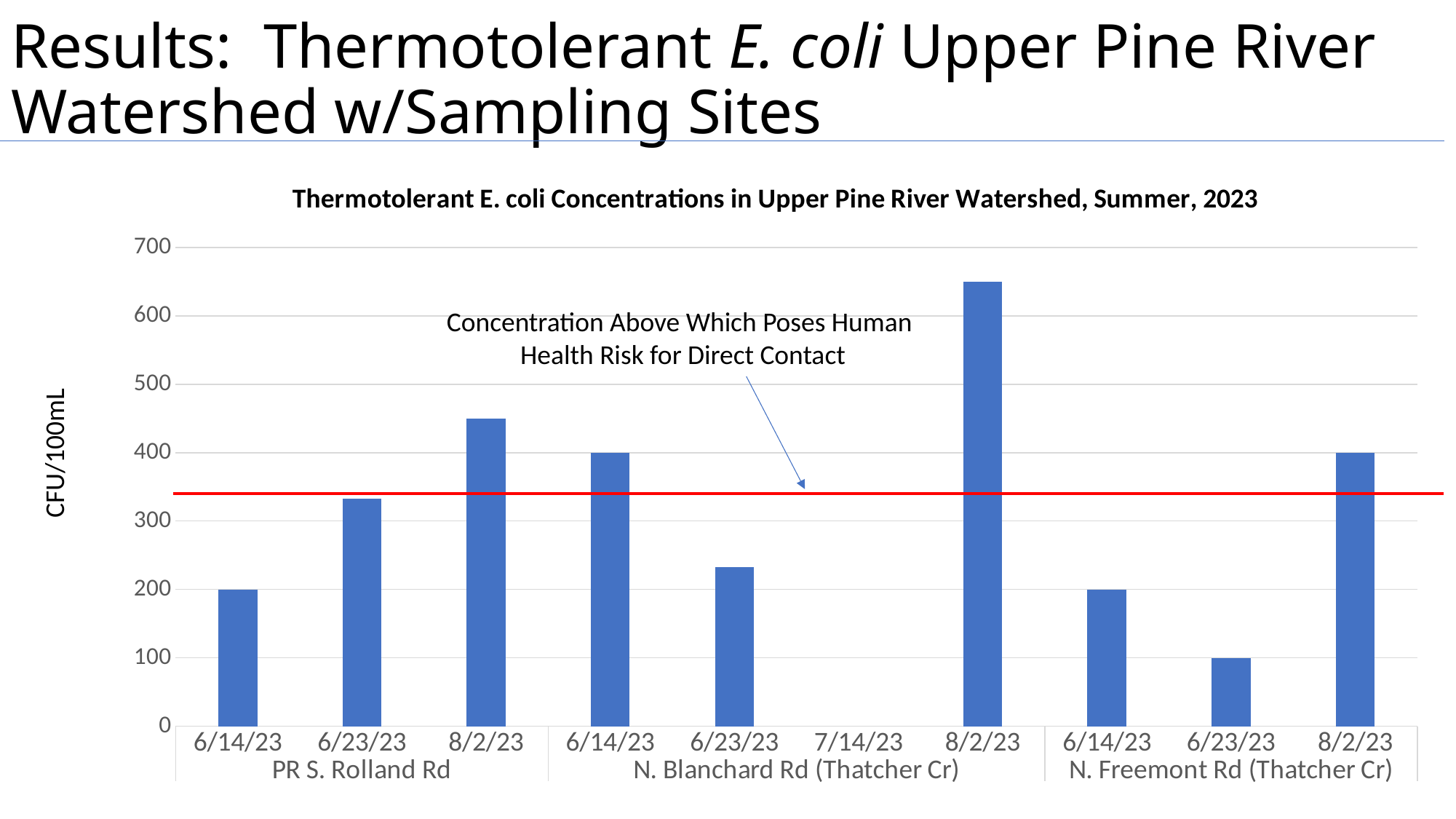
What type of chart is shown on the slide? bar chart Which date and site has the lowest non-zero E. coli concentration in the chart? 6/23/23, N. Freemont Rd (Thatcher Cr) What is the title of the chart? Thermotolerant E. coli Concentrations in Upper Pine River Watershed, Summer, 2023 What is the E. coli concentration for PR S. Rolland Rd on 6/14/23? 200 Which date and site has the highest E. coli concentration in the chart? 8/2/23, N. Blanchard Rd (Thatcher Cr) How many sampling sites are shown along the x axis of the chart? 3 Which is larger: the value for PR S. Rolland Rd on 8/2/23 or the value for N. Blanchard Rd (Thatcher Cr) on 6/23/23? PR S. Rolland Rd on 8/2/23 Is the value for N. Blanchard Rd (Thatcher Cr) on 8/2/23 greater or less than 600? greater What is the E. coli concentration for N. Blanchard Rd (Thatcher Cr) on 6/14/23? 400 What is the label on the vertical axis of the chart? CFU/100mL What is the E. coli concentration for N. Freemont Rd (Thatcher Cr) on 8/2/23? 400 What is the E. coli concentration for N. Freemont Rd (Thatcher Cr) on 6/23/23? 100